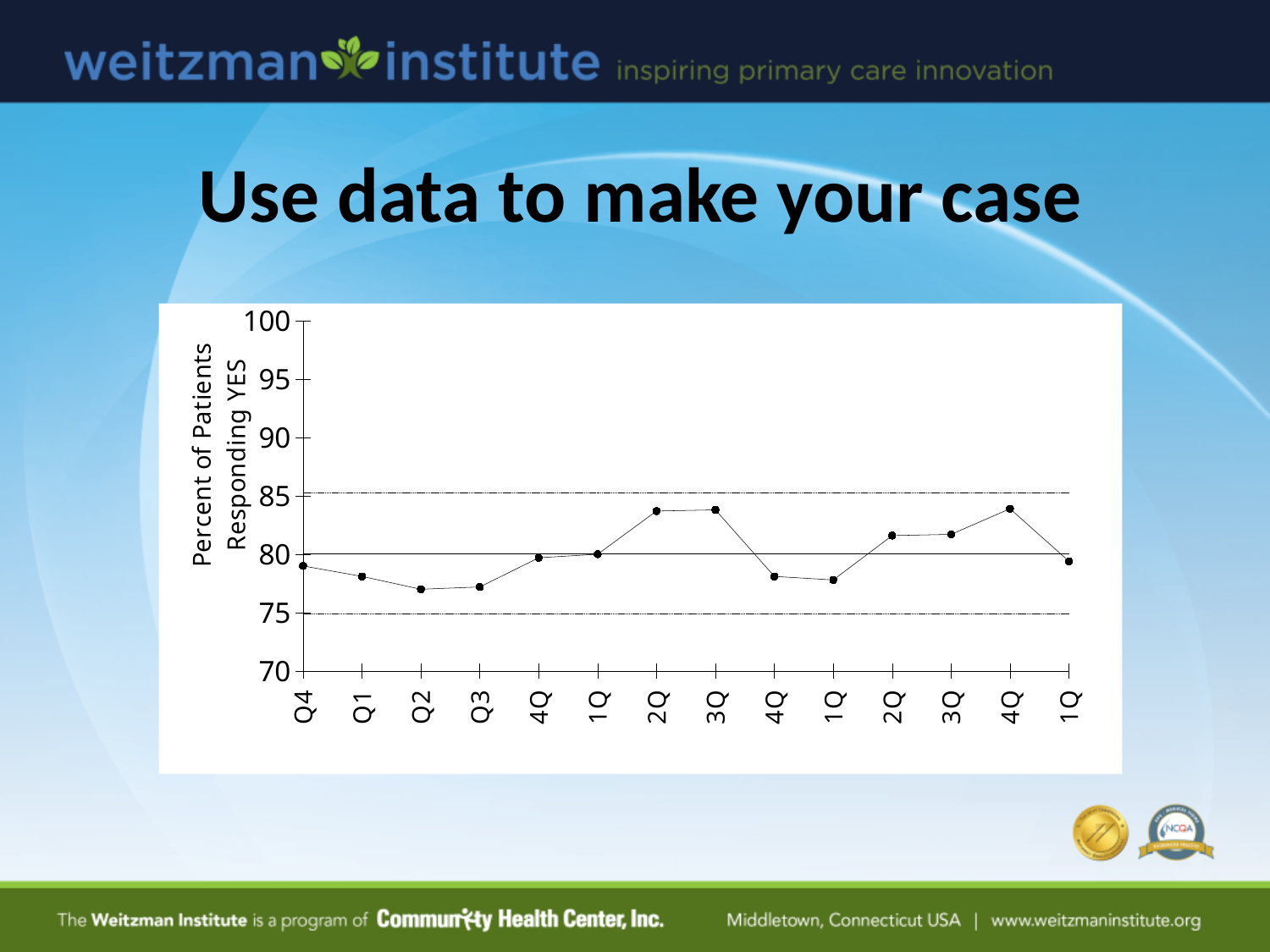
What is the highest value shown on the vertical axis? 100 Is the value for the seventh point (2Q) greater or less than 80? greater Is the value for the third point (Q2) greater or less than 75? greater What kind of chart is shown on the slide? line chart Is the value for the first point (Q4) greater or less than 80? less Which is larger, the value for the eighth point (3Q) or the ninth point (4Q)? 3Q (eighth point) What is the label on the vertical axis? Percent of Patients Responding YES Which is larger, the value for the third point (Q2) or the seventh point (2Q)? 2Q (seventh point) How many data points are plotted on the line? 14